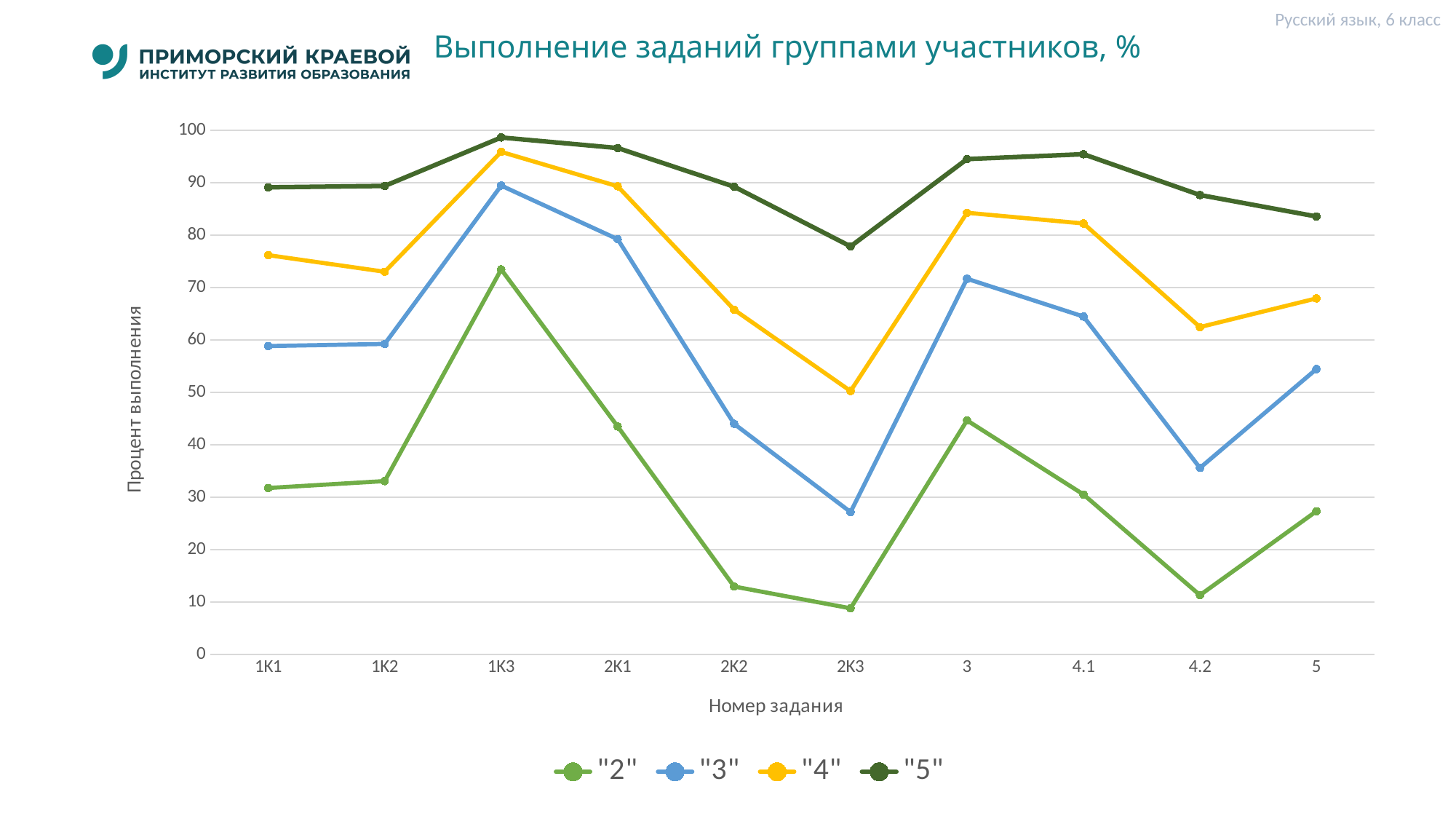
For which task does the "2" series reach its highest value? 1К3 How many series does the legend list? 4 Is the value for the "4" series at task 2К3 greater or less than 60? less What kind of chart is shown on the slide? line chart How many task numbers are shown along the x axis? 10 For which task does the "5" series reach its lowest value? 2К3 For which task does the "2" series reach its lowest value? 2К3 For which task does the "4" series reach its highest value? 1К3 Which is larger for the "4" series: the value at task 1К1 or the value at task 5? 1К1 Does the "3" series rise or fall from task 1К3 to task 2К3? fall Is the value for the "2" series at task 2К2 greater or less than 20? less Is the value for the "3" series at task 1К3 greater or less than 80? greater